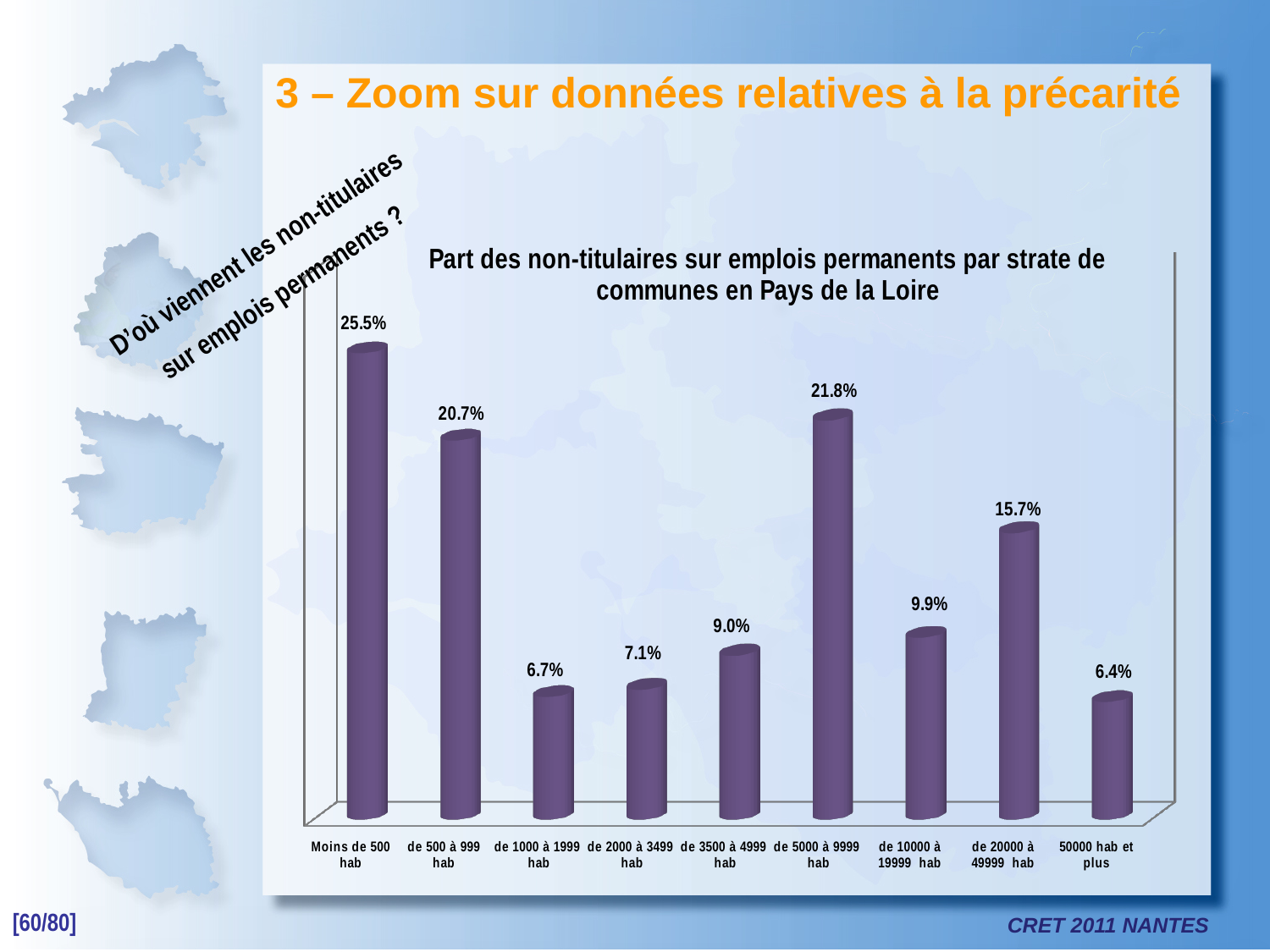
What is the title of the chart? Part des non-titulaires sur emplois permanents par strate de communes en Pays de la Loire What is the value for 'Moins de 500 hab'? 25.5% What is the difference between the values for 'de 5000 à 9999 hab' and 'de 10000 à 19999 hab'? 11.9% Which is larger, the value for 'de 3500 à 4999 hab' or the value for 'de 10000 à 19999 hab'? de 10000 à 19999 hab What kind of chart is this? bar chart How many categories are shown on the x axis? 9 What is the value for 'de 20000 à 49999 hab'? 15.7% What is the difference between the values for 'Moins de 500 hab' and 'de 500 à 999 hab'? 4.8% What is the value for 'de 5000 à 9999 hab'? 21.8% Which category has the highest value? Moins de 500 hab What is the value for 'de 1000 à 1999 hab'? 6.7% Which category has the lowest value? 50000 hab et plus